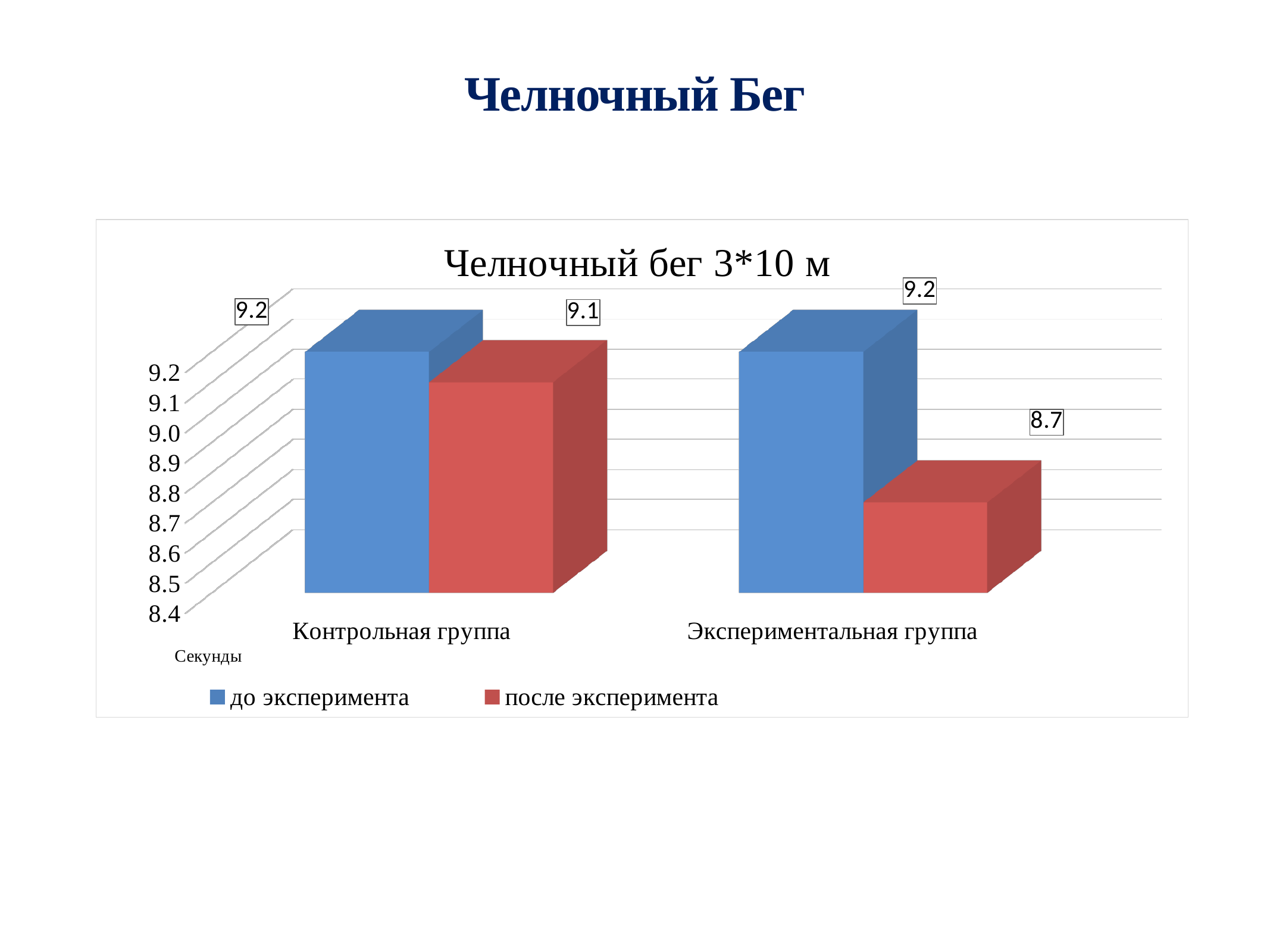
Which is larger: the после эксперимента value for Контрольная группа or for Экспериментальная группа? Контрольная группа Which group has the lowest value in the после эксперимента series? Экспериментальная группа How many groups (categories) are shown on the x axis? 2 What is the value for Экспериментальная группа in the после эксперимента series? 8.7 How many series does the legend list? 2 What is the value for Контрольная группа in the после эксперимента series? 9.1 What is the value for Экспериментальная группа in the до эксперимента series? 9.2 What is the title of the chart? Челночный бег 3*10 м What is the value for Контрольная группа in the до эксперимента series? 9.2 What kind of chart is shown on the slide? Bar chart What is the difference between the до эксперимента and после эксперимента values for Контрольная группа? 0.1 What is the difference between the до эксперимента and после эксперимента values for Экспериментальная группа? 0.5